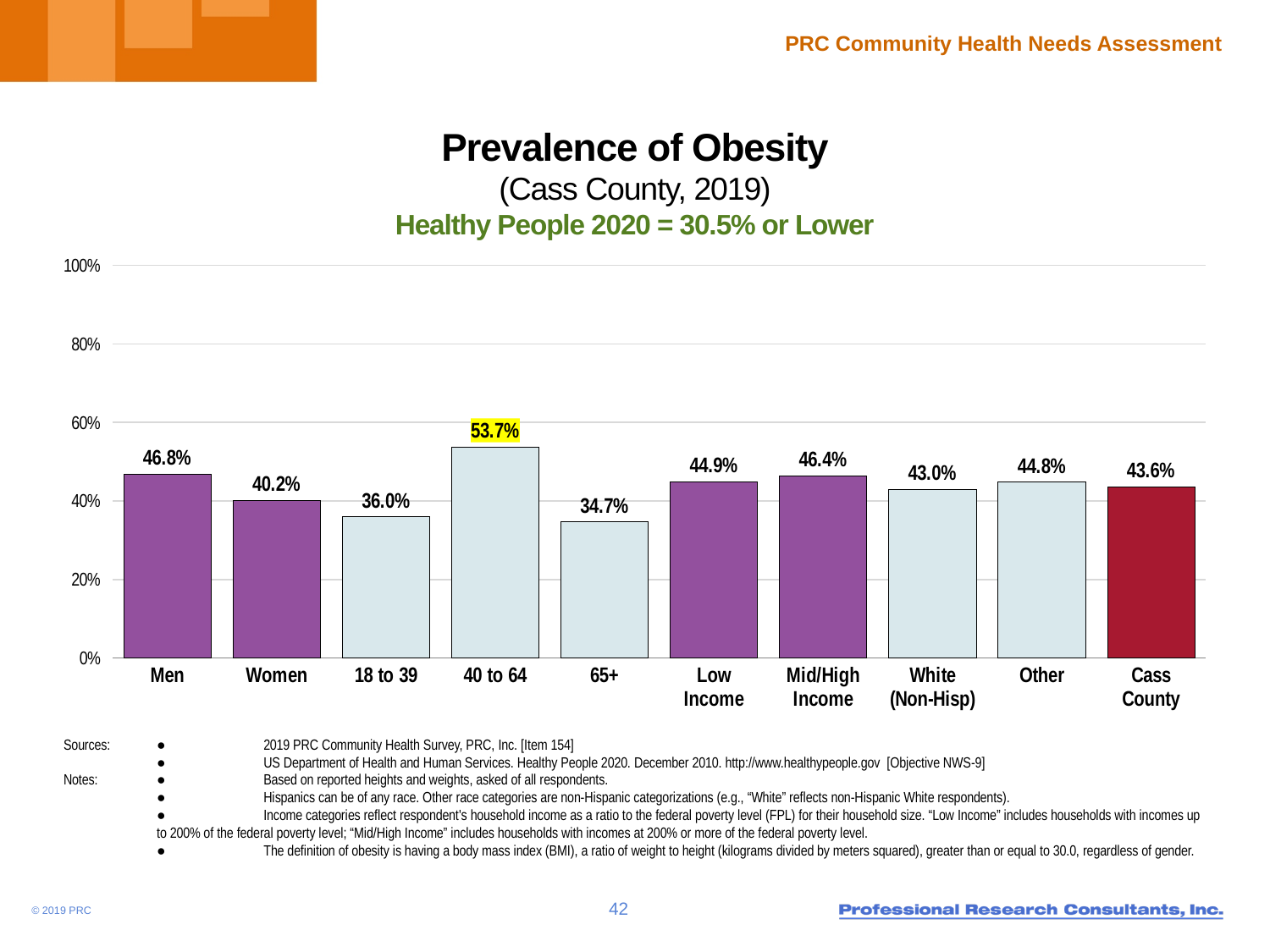
Which has a higher prevalence of obesity, Low Income or Mid/High Income? Mid/High Income Is the value for 18 to 39 greater or less than 40%? less What is the difference in obesity prevalence between Men and Women? 6.6% Which category has the lowest prevalence of obesity? 65+ How many categories are shown on the chart? 10 What is the prevalence of obesity for Cass County overall? 43.6% Which category has the highest prevalence of obesity? 40 to 64 What is the prevalence of obesity for the 40 to 64 age group? 53.7% What is the prevalence of obesity for White (Non-Hisp) respondents? 43.0% What is the prevalence of obesity for Men? 46.8% What kind of chart is shown on the slide? Bar chart What is the Healthy People 2020 target stated in the chart subtitle? 30.5% or Lower